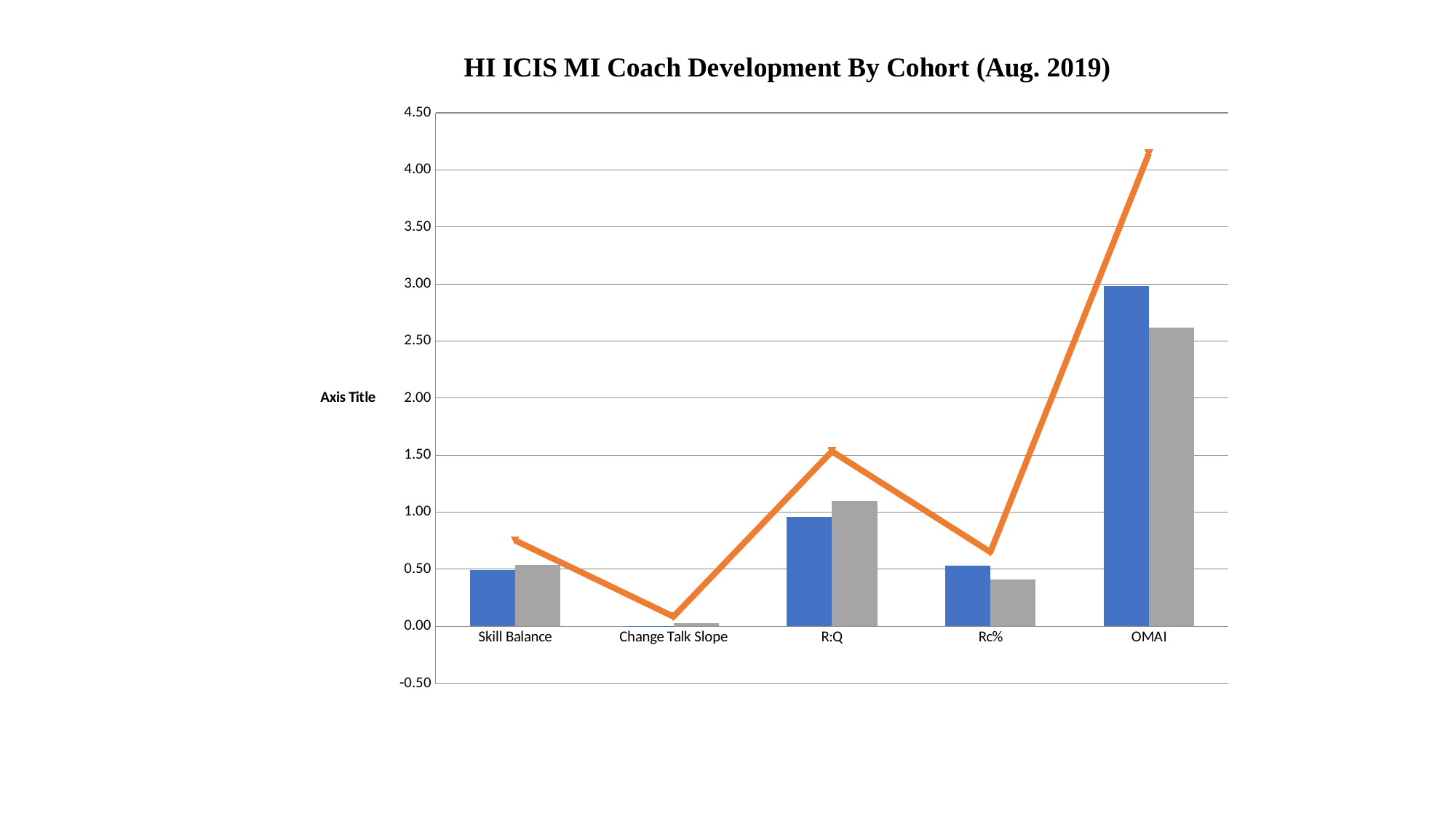
Which category has the highest value on the orange line? OMAI Is the orange line value for Skill Balance greater or less than 0.50? greater Is the gray bar value for Rc% greater or less than 0.50? less Is the gray bar value for OMAI greater or less than 2.50? greater For R:Q, which is larger, the blue bar or the gray bar? The gray bar How many categories are shown on the x axis of the chart? 5 Which category has the shortest gray bar? Change Talk Slope What is the title of the chart? HI ICIS MI Coach Development By Cohort (Aug. 2019) Which category has the tallest blue bar? OMAI Which category has the lowest value on the orange line? Change Talk Slope What kind of chart is this? Combined bar and line chart